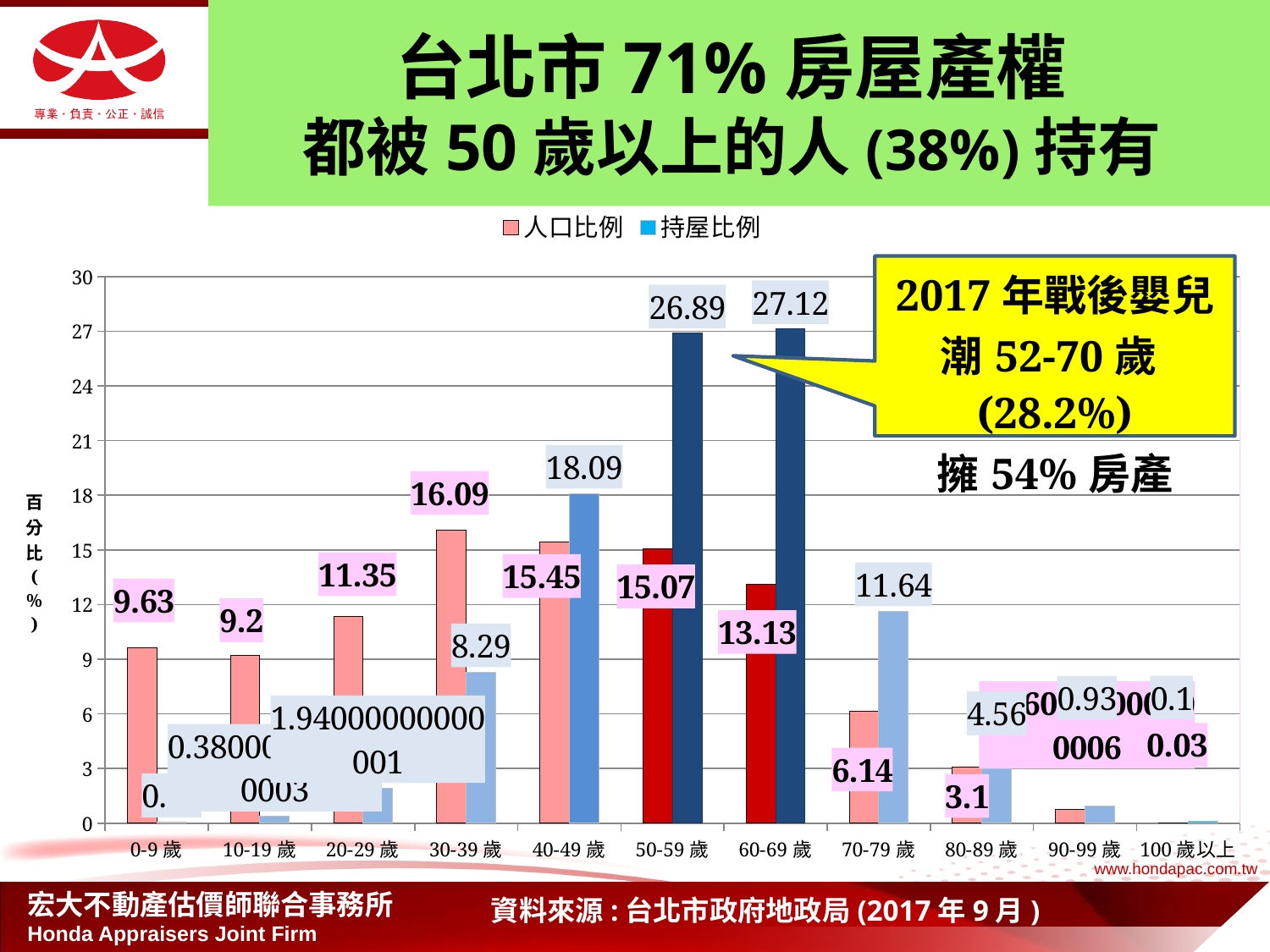
What kind of chart is shown on the slide? bar chart What is the 人口比例 value for the 30-39歲 group? 16.09 What is the 持屋比例 value for the 40-49歲 group? 18.09 What are the two legend entries of the chart? 人口比例 and 持屋比例 For the 70-79歲 group, which is larger: 人口比例 or 持屋比例? 持屋比例 How many age categories are shown on the x axis? 11 Is the 持屋比例 value for the 50-59歲 group greater or less than 24? greater What is the difference between the 持屋比例 values for 40-49歲 and 30-39歲? 9.8 How many series does the legend list? 2 What is the 持屋比例 value for the 60-69歲 group? 27.12 Which age group has the highest 人口比例 value? 30-39歲 Which age group has the highest 持屋比例 value? 60-69歲